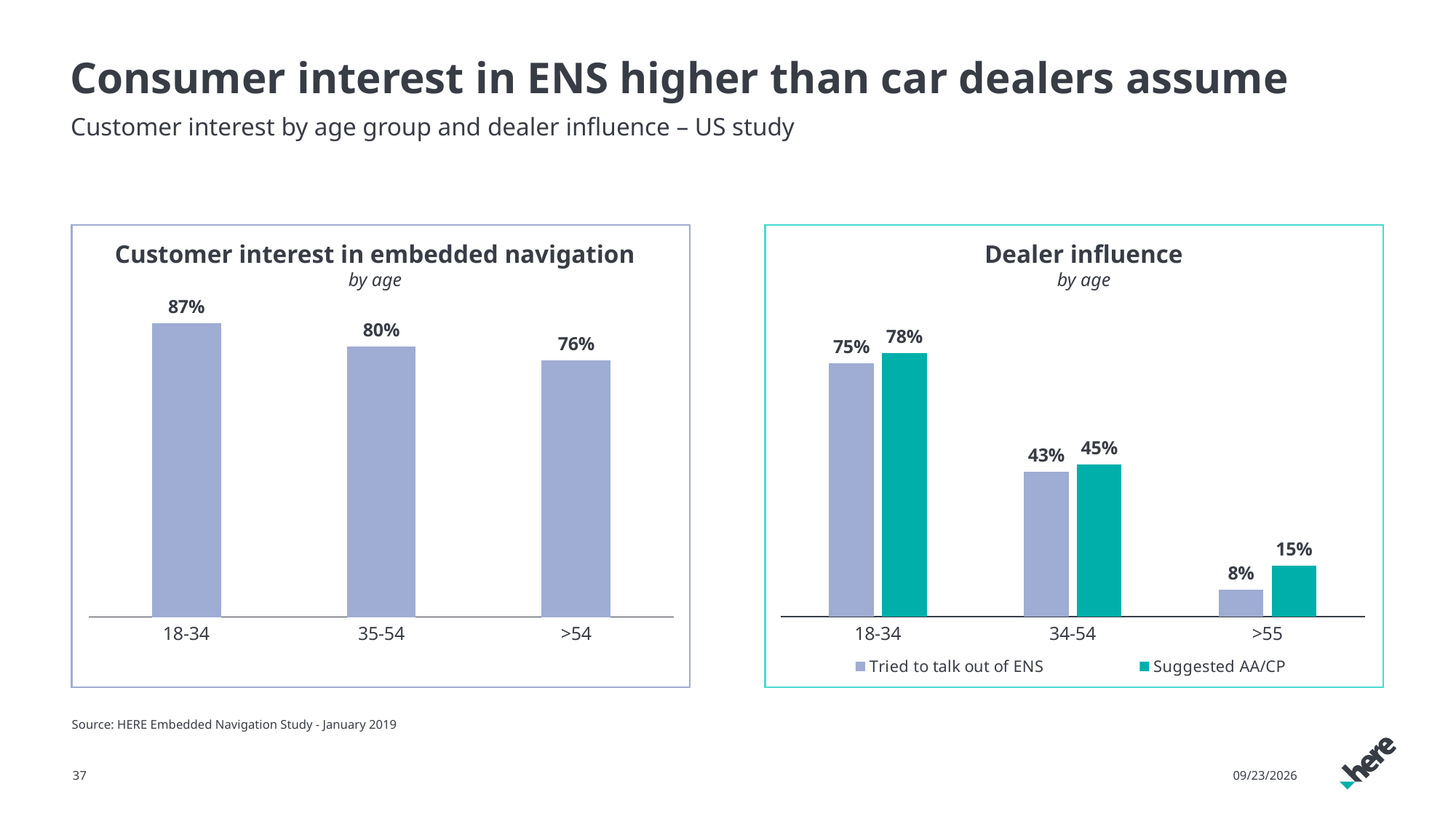
In the 'Customer interest in embedded navigation' chart, what is the difference between the 18-34 and >54 values? 11 percentage points How many series does the legend of the 'Dealer influence' chart list? 2 In the 'Customer interest in embedded navigation' chart, how many age groups are shown? 3 In the 'Customer interest in embedded navigation' chart, which age group has the lowest value? >54 In the 'Dealer influence' chart, what is the 'Suggested AA/CP' value for the 34-54 age group? 45% In the 'Dealer influence' chart, which is larger for the 18-34 age group: 'Tried to talk out of ENS' or 'Suggested AA/CP'? Suggested AA/CP What type of chart is the 'Dealer influence' chart? bar chart In the 'Dealer influence' chart, what is the 'Tried to talk out of ENS' value for the >55 age group? 8% In the 'Customer interest in embedded navigation' chart, do the values rise or fall from the youngest to the oldest age group? fall In the 'Customer interest in embedded navigation' chart, what is the value for the 18-34 age group? 87% In the 'Dealer influence' chart, which age group has the highest 'Suggested AA/CP' value? 18-34 In the 'Dealer influence' chart, what is the difference between 'Suggested AA/CP' and 'Tried to talk out of ENS' for the >55 age group? 7 percentage points